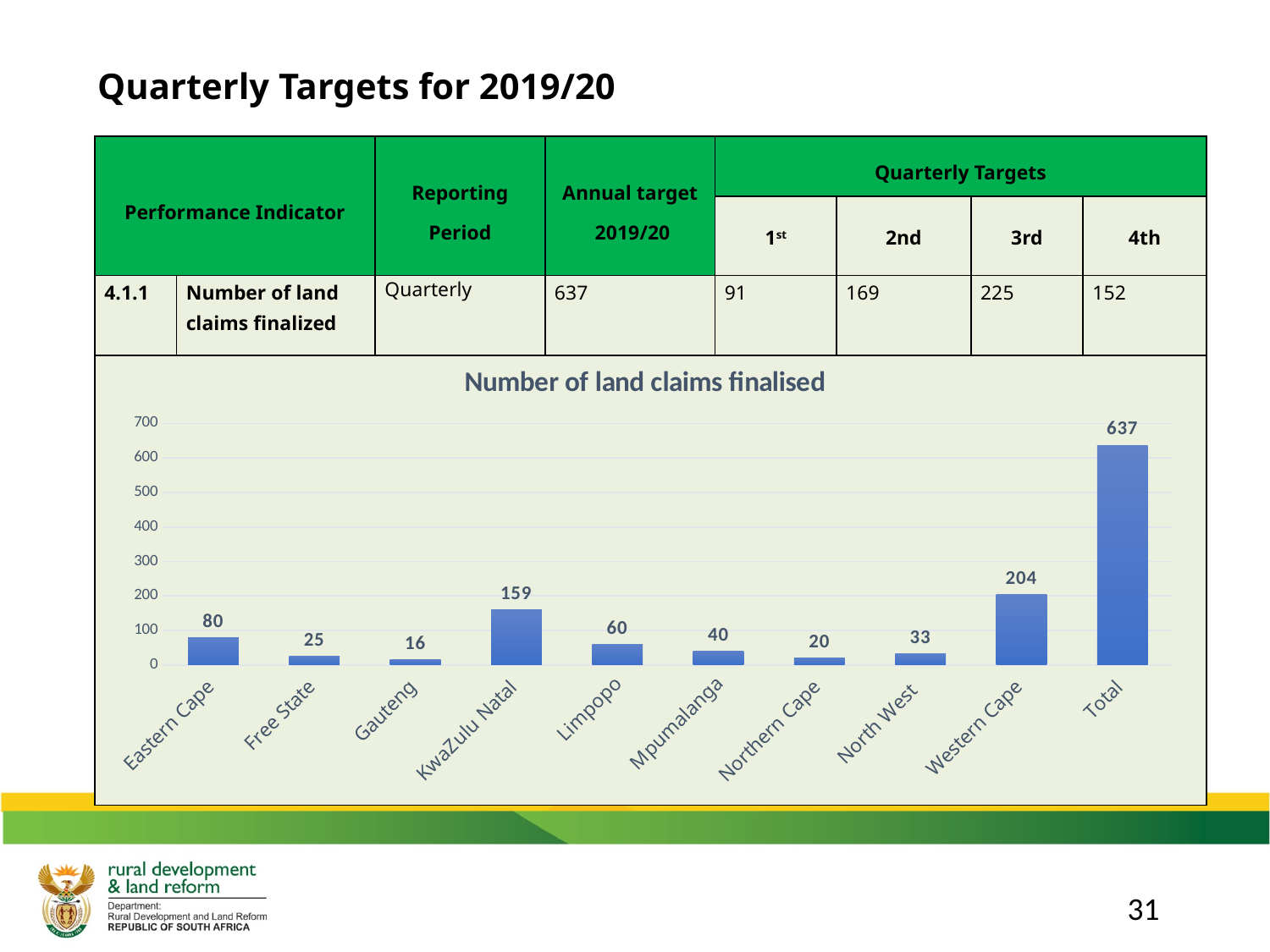
Is the value for the Total bar greater or less than 600? greater Excluding the Total bar, which province has the highest number of land claims finalised? Western Cape Which is larger, the value for Limpopo or the value for Mpumalanga? Limpopo What is the title of the chart? Number of land claims finalised What kind of chart is shown on the slide? bar chart What is the value for North West in the chart? 33 What is the value for Gauteng in the chart? 16 What is the value for Western Cape in the chart? 204 What is the difference between the values for Eastern Cape and Free State? 55 What is the value for KwaZulu Natal in the chart? 159 How many bars are shown in the chart, including the Total bar? 10 Which province has the lowest number of land claims finalised? Gauteng